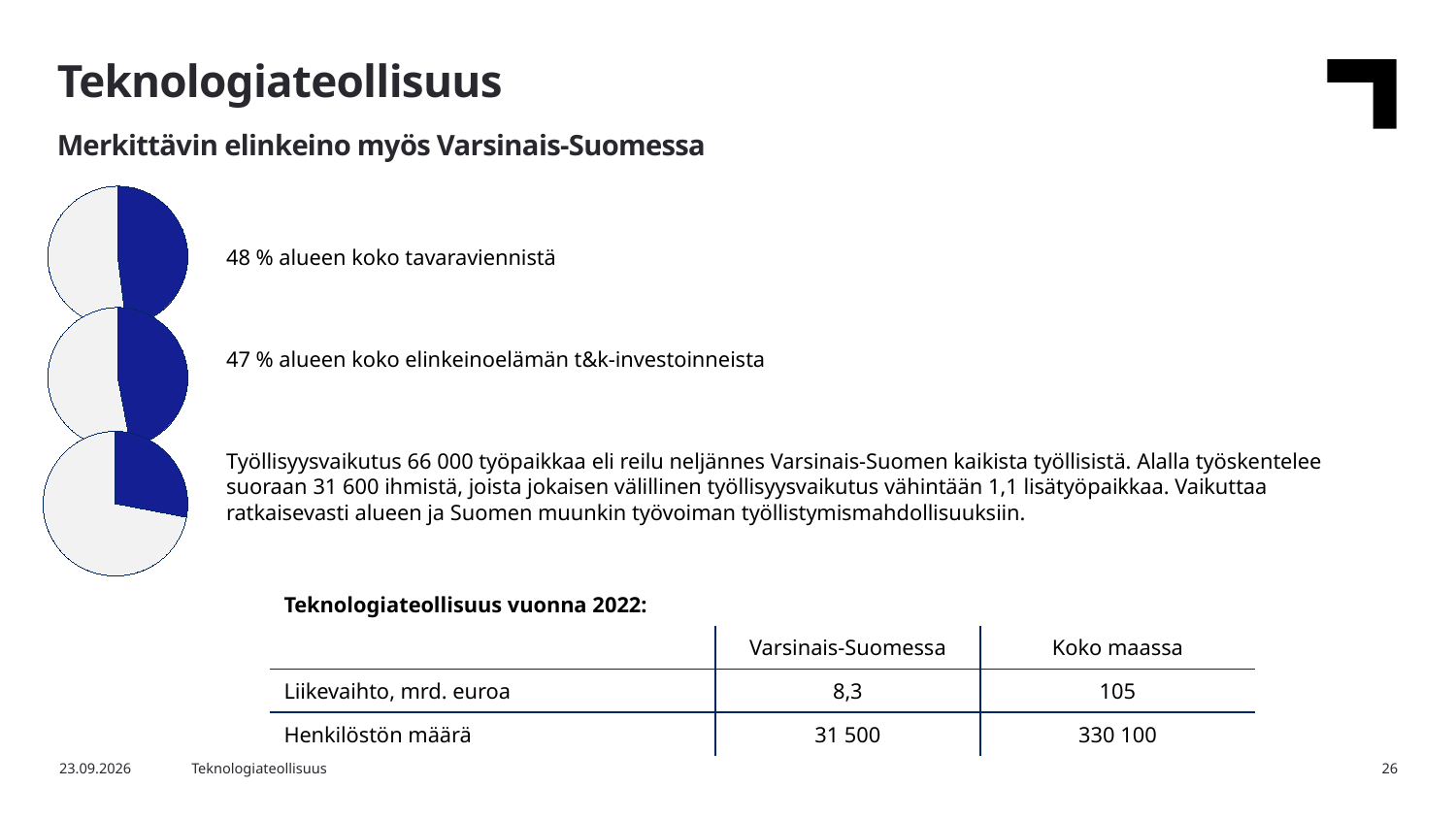
What kind of charts are shown on the left side of the slide? Pie charts What does the bottom pie chart illustrate? The technology industry's employment impact as a share of all employed in Varsinais-Suomi (reilu neljännes) According to the top pie chart, what share of the region's total goods exports does the technology industry account for? 48 % According to the middle pie chart, what share of the region's business R&D investments does the technology industry account for? 47 % How many jobs does the text next to the bottom pie chart give as the employment impact? 66 000 Which pie chart has the smallest highlighted (blue) slice: the top, middle or bottom one? Bottom How many pie charts are on the slide? 3 What colour is used for the highlighted slice in each pie chart? Blue Is the highlighted share in the top pie chart (goods exports) larger or smaller than in the middle pie chart (R&D investments)? Larger In the bottom pie chart, is the highlighted blue slice greater or less than 50 %? less